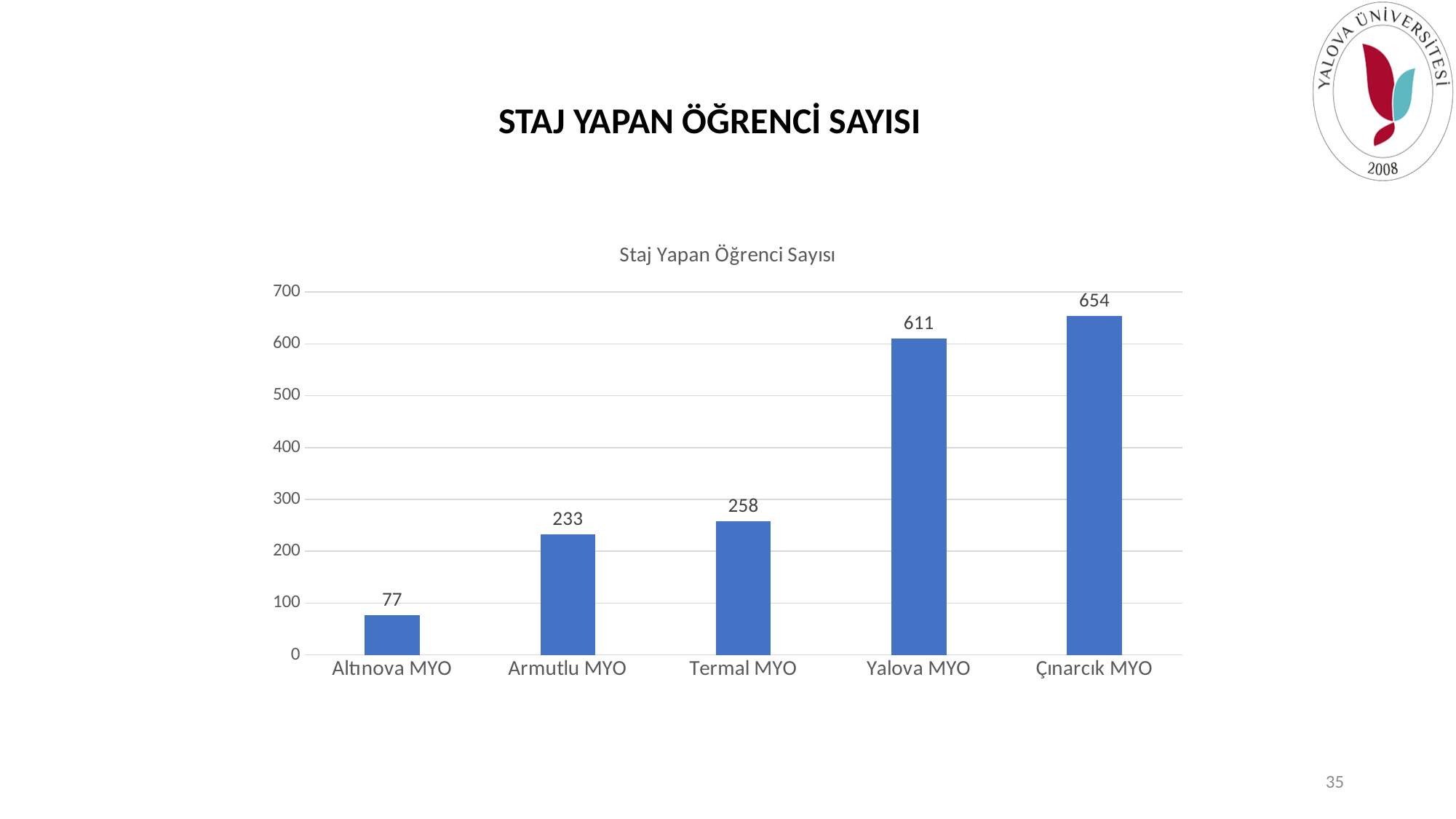
What is the difference between the values for Termal MYO and Armutlu MYO? 25 Which category has the highest value? Çınarcık MYO What is the value for Altınova MYO? 77 What is the title of the chart? Staj Yapan Öğrenci Sayısı How many categories are shown on the x axis? 5 What kind of chart is shown on the slide? Bar chart Which category has the lowest value? Altınova MYO Which is larger, the value for Yalova MYO or the value for Termal MYO? Yalova MYO What is the difference between the values for Çınarcık MYO and Yalova MYO? 43 What is the value for Armutlu MYO? 233 What is the value for Termal MYO? 258 What is the value for Yalova MYO? 611